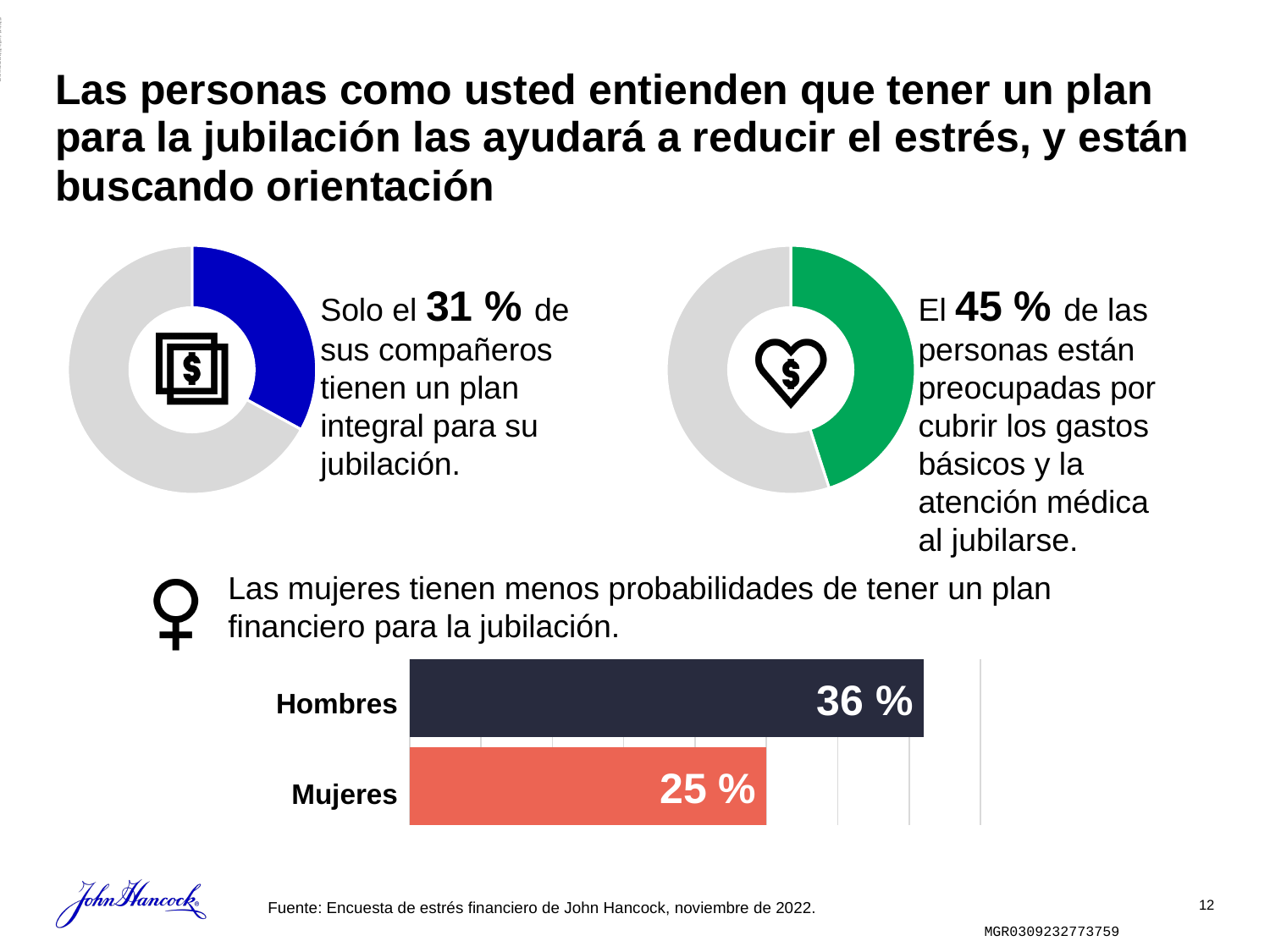
In the bar chart at the bottom of the slide, what is the difference between the values for Hombres and Mujeres? 11 % In the bar chart at the bottom of the slide, what colour is the bar for Mujeres? red How many categories does the bar chart at the bottom of the slide show? 2 What kind of chart is shown at the bottom of the slide with Hombres and Mujeres? bar chart In the bar chart at the bottom of the slide, what is the value for Hombres? 36 % In the bar chart at the bottom of the slide, is the value for Hombres larger or smaller than the value for Mujeres? larger In the bar chart at the bottom of the slide, which category has the lower value? Mujeres What share does the green segment represent in the donut chart on the right of the slide? 45 % In the bar chart at the bottom of the slide, what is the value for Mujeres? 25 % In the bar chart at the bottom of the slide, which category has the higher value? Hombres What kind of chart is used on the left of the slide to show the 31 % figure? donut chart What share does the blue segment represent in the donut chart on the left of the slide? 31 %